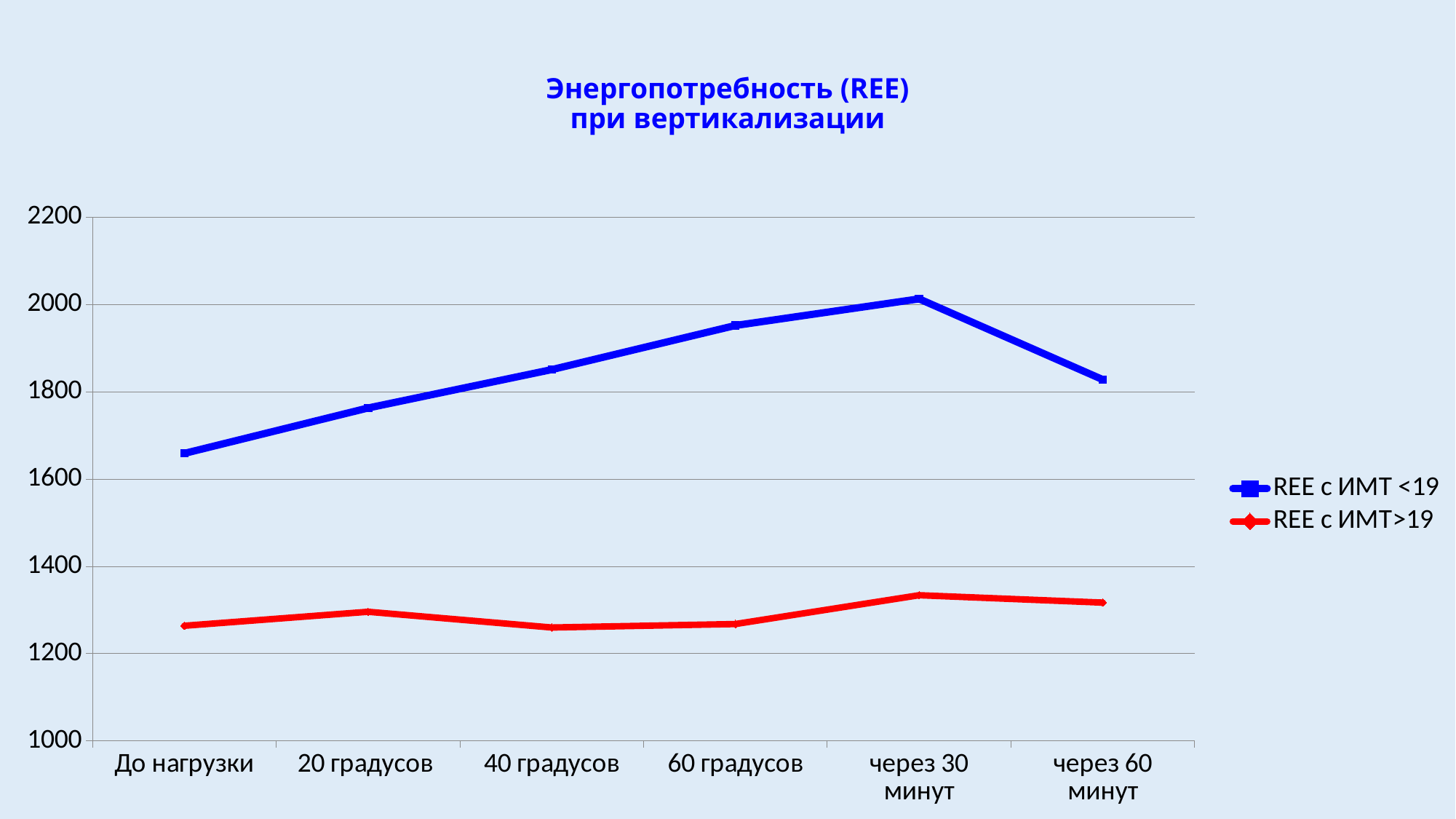
Is the value for 'REE с ИМТ <19' at 'До нагрузки' greater or less than 1600? greater At which category does the series 'REE с ИМТ>19' reach its highest value? через 30 минут Which series has the larger value at '40 градусов': 'REE с ИМТ <19' or 'REE с ИМТ>19'? REE с ИМТ <19 Is the value for 'REE с ИМТ>19' at 'через 30 минут' greater or less than 1400? less What kind of chart is shown on the slide? line chart Does the series 'REE с ИМТ <19' rise or fall from 'До нагрузки' to '60 градусов'? rise At which category does the series 'REE с ИМТ <19' reach its highest value? через 30 минут At which category does the series 'REE с ИМТ <19' have its lowest value? До нагрузки How many series does the legend list? 2 What colour is the line for the series 'REE с ИМТ>19'? red How many categories are shown along the x axis? 6 Is the value for 'REE с ИМТ <19' at '60 градусов' greater or less than 2000? less